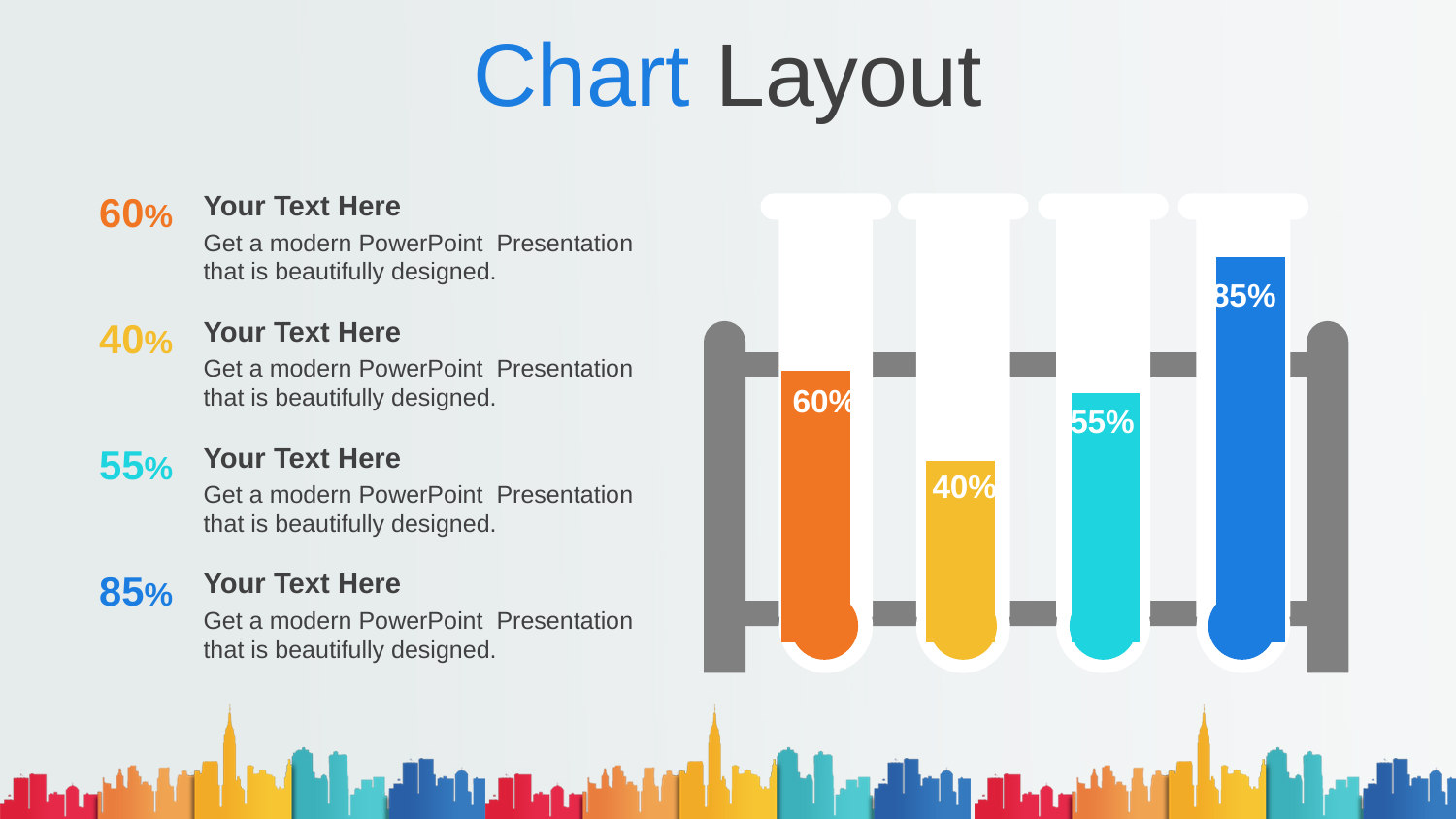
What value is shown in the orange test tube (first from the left)? 60% What is the title of the slide containing the chart? Chart Layout Which test tube shows the lowest value? The yellow one (second from left), 40% What value is shown in the yellow test tube (second from the left)? 40% Which is larger, the value in the orange test tube or the value in the cyan test tube? The orange test tube (60%) What is the difference between the value in the orange test tube and the value in the cyan test tube? 5% What colour is the test tube that shows 55%? Cyan What value is shown in the cyan test tube (third from the left)? 55% Which test tube shows the highest value? The blue one (rightmost), 85% What is the difference between the value in the blue test tube and the value in the yellow test tube? 45% What value is shown in the blue test tube (rightmost)? 85% How many test tubes (data points) are shown in the chart? 4